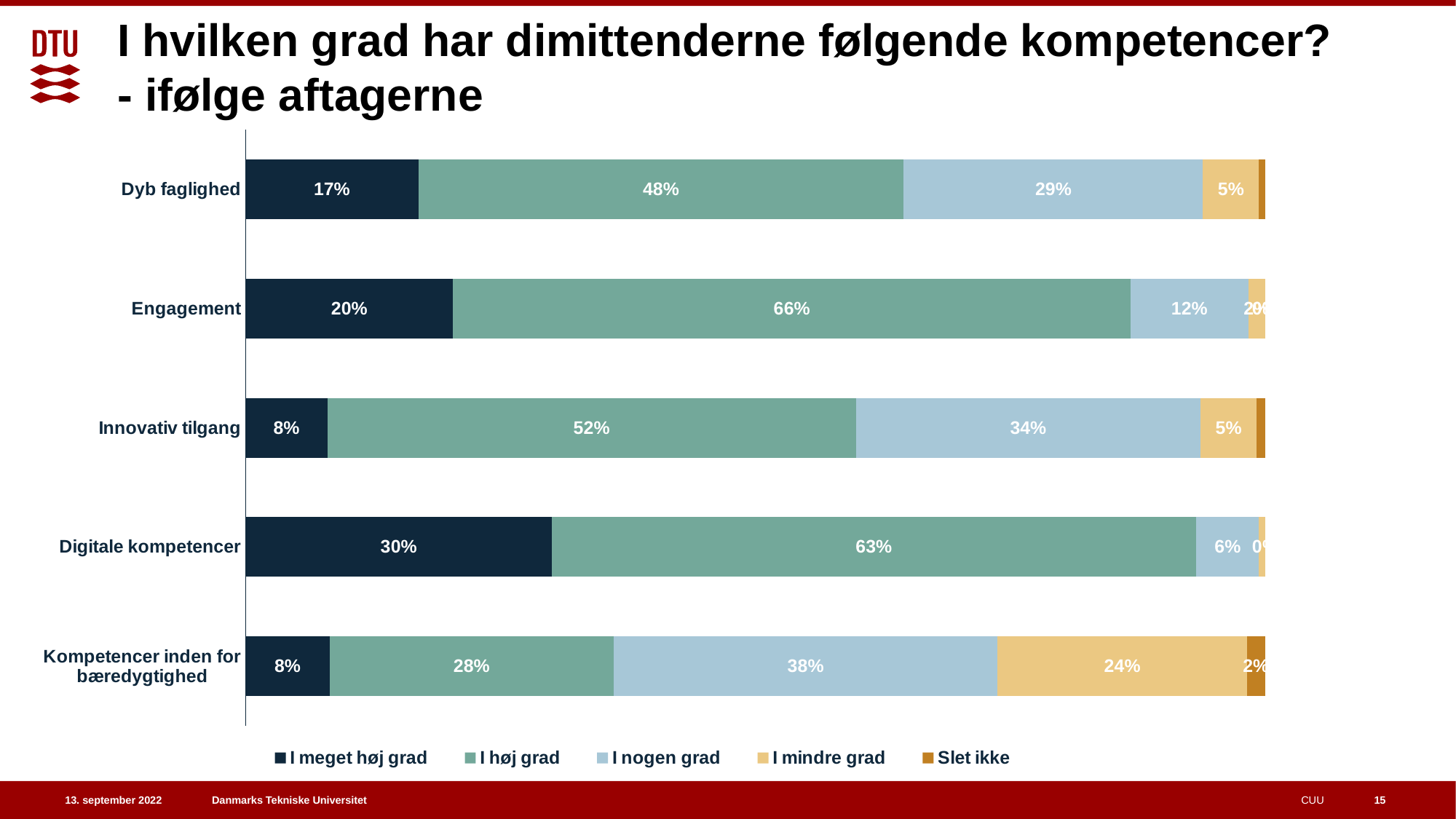
What share of respondents answered 'I mindre grad' for Innovativ tilgang? 5% What share of respondents answered 'I nogen grad' for Kompetencer inden for bæredygtighed? 38% Which competency has the lowest 'I høj grad' share? Kompetencer inden for bæredygtighed What is the difference between the 'I høj grad' share for Engagement and for Dyb faglighed? 18 percentage points How many series does the legend list? 5 Which legend entry is shown in the darkest colour? I meget høj grad How many competencies (categories) are listed on the chart? 5 Which is larger: the 'I nogen grad' share for Innovativ tilgang or for Dyb faglighed? Innovativ tilgang What share of respondents answered 'I høj grad' for Engagement? 66% What kind of chart is shown on the slide? stacked bar chart What share of respondents answered 'I meget høj grad' for Digitale kompetencer? 30% Which competency has the highest 'I meget høj grad' share? Digitale kompetencer